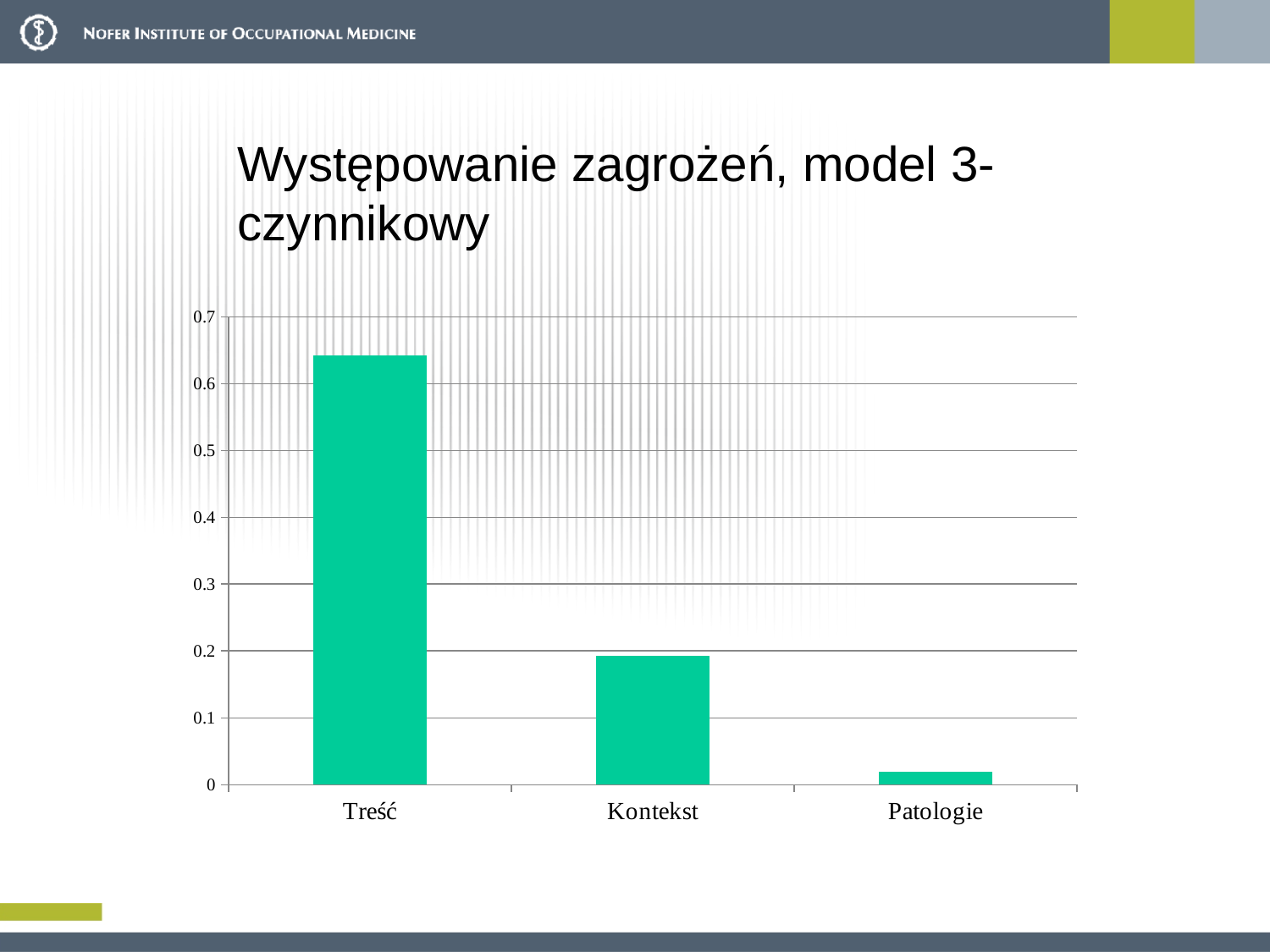
What is the title of the slide containing the chart? Występowanie zagrożeń, model 3-czynnikowy Do the bar values rise or fall from left to right across the categories? fall Is the value for Patologie greater or less than 0.1? less Is the value for Treść greater or less than 0.7? less Which is larger, the value for Treść or the value for Kontekst? Treść How many categories are shown on the x axis of the chart? 3 Which is larger, the value for Kontekst or the value for Patologie? Kontekst Which category has the highest bar in the chart? Treść What kind of chart is shown on the slide? bar chart Is the value for Treść greater or less than 0.6? greater Which category has the lowest bar in the chart? Patologie